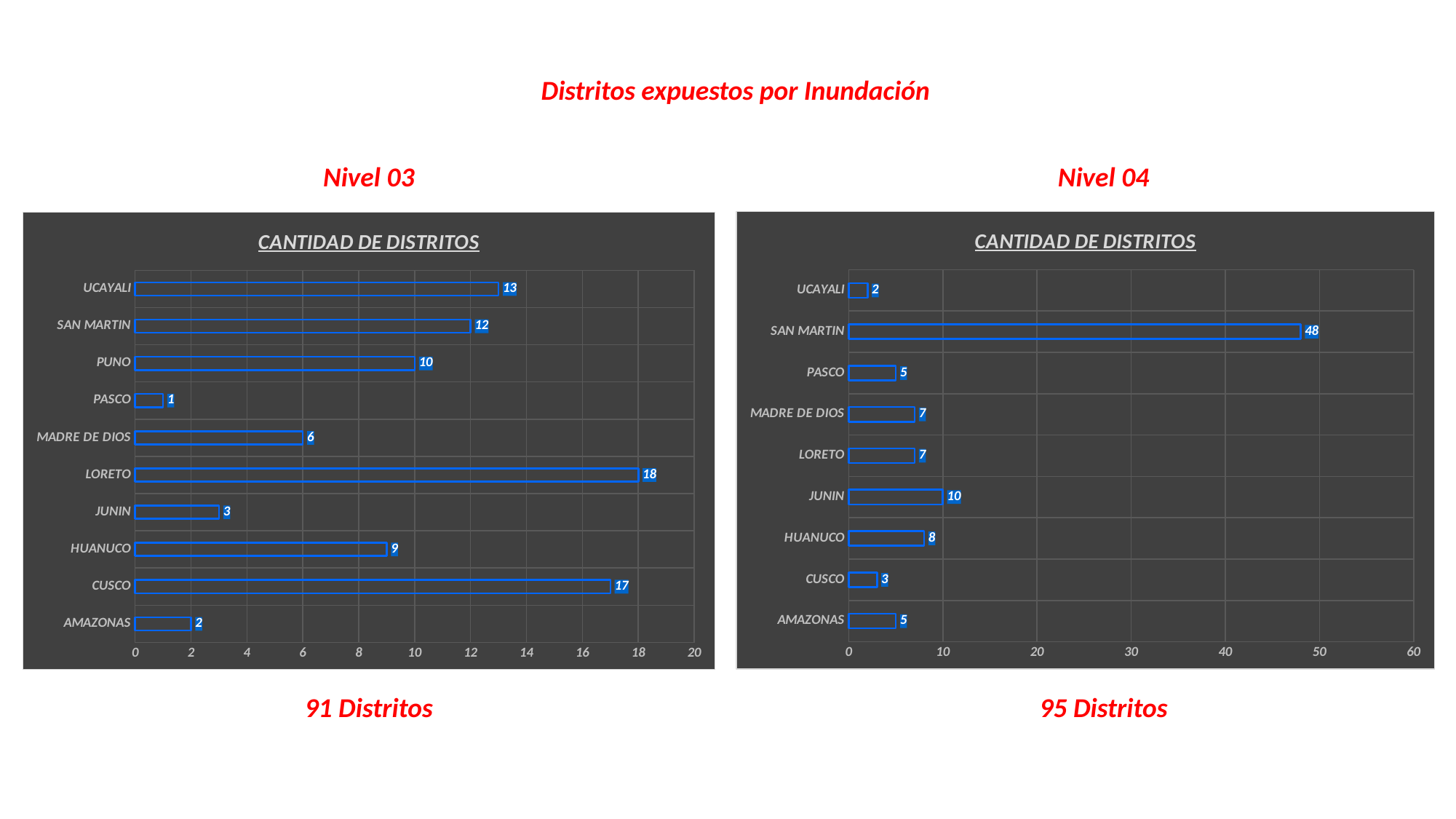
In the Nivel 03 chart, what is the value for LORETO? 18 What kind of chart is the Nivel 04 chart? Bar chart How many categories are shown in the Nivel 03 chart? 10 In the Nivel 03 chart, which category has the lowest value? PASCO In the Nivel 03 chart, which category has the highest value? LORETO In the Nivel 04 chart, is the value for SAN MARTIN greater or less than 40? greater In the Nivel 04 chart, what is the value for SAN MARTIN? 48 What is the title shown inside the Nivel 03 chart? CANTIDAD DE DISTRITOS In the Nivel 04 chart, which category has the lowest value? UCAYALI How many categories are shown in the Nivel 04 chart? 9 In the Nivel 03 chart, what is the difference between the values for CUSCO and HUANUCO? 8 In the Nivel 04 chart, which is larger, the value for JUNIN or the value for HUANUCO? JUNIN